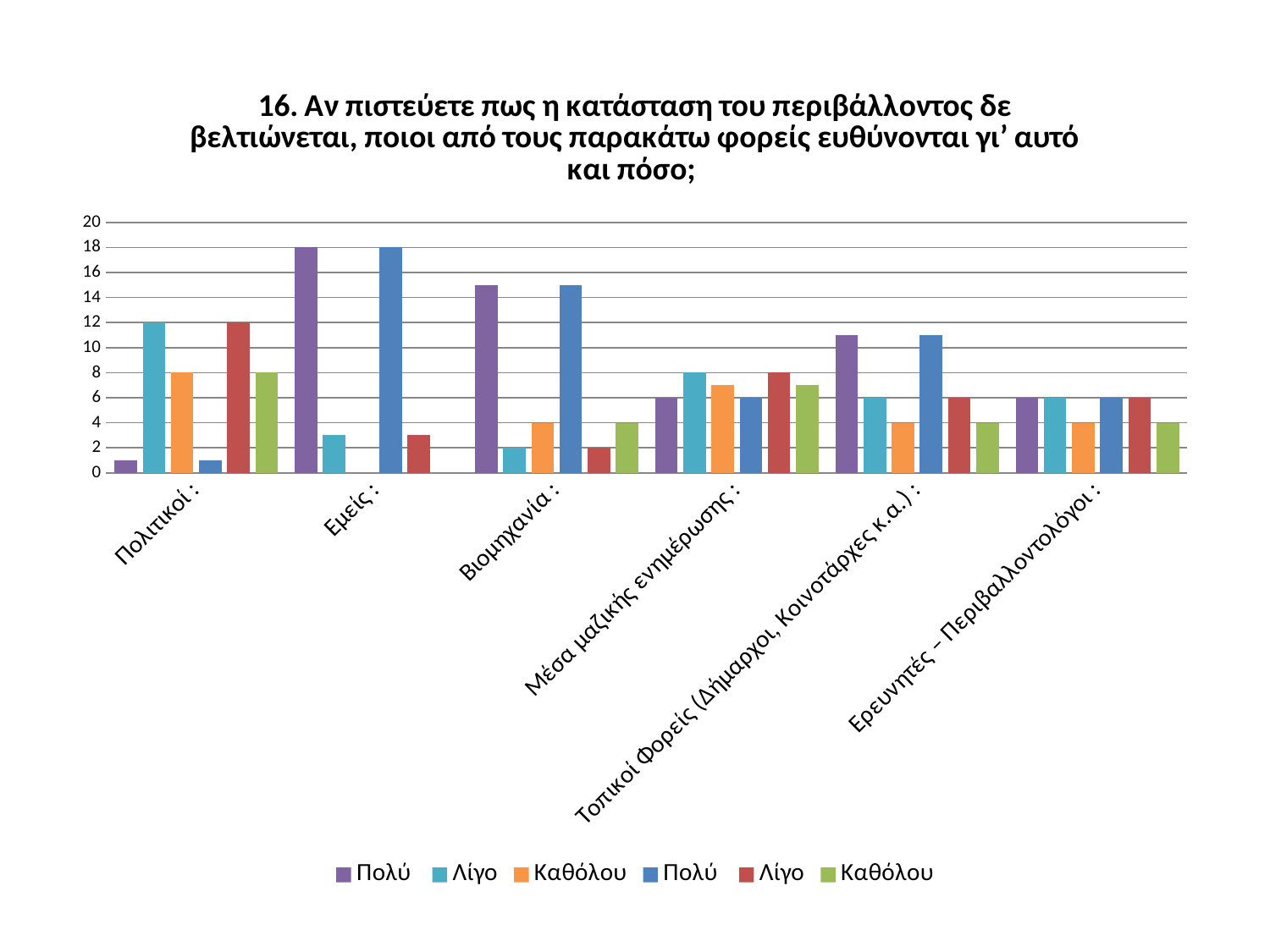
What is the value of the first Λίγο series (teal) for Μέσα μαζικής ενημέρωσης? 8 How many categories are shown on the x axis of the chart? 6 Is the first Πολύ (purple) value for Βιομηχανία greater or less than 10? greater Which category has the lowest value for the first Πολύ series (purple)? Πολιτικοί What is the value of the first Λίγο series (teal) for Πολιτικοί? 12 Which category has the highest value for the first Πολύ series (purple)? Εμείς What is the difference between the first Λίγο (teal) and first Καθόλου (orange) values for Πολιτικοί? 4 What kind of chart is shown on the slide? bar chart How many series does the chart's legend list? 6 For Πολιτικοί, which is larger: the first Πολύ (purple) value or the first Λίγο (teal) value? Λίγο (teal) What is the value of the first Πολύ series (purple) for Εμείς? 18 What is the value of the first Καθόλου series (orange) for Πολιτικοί? 8